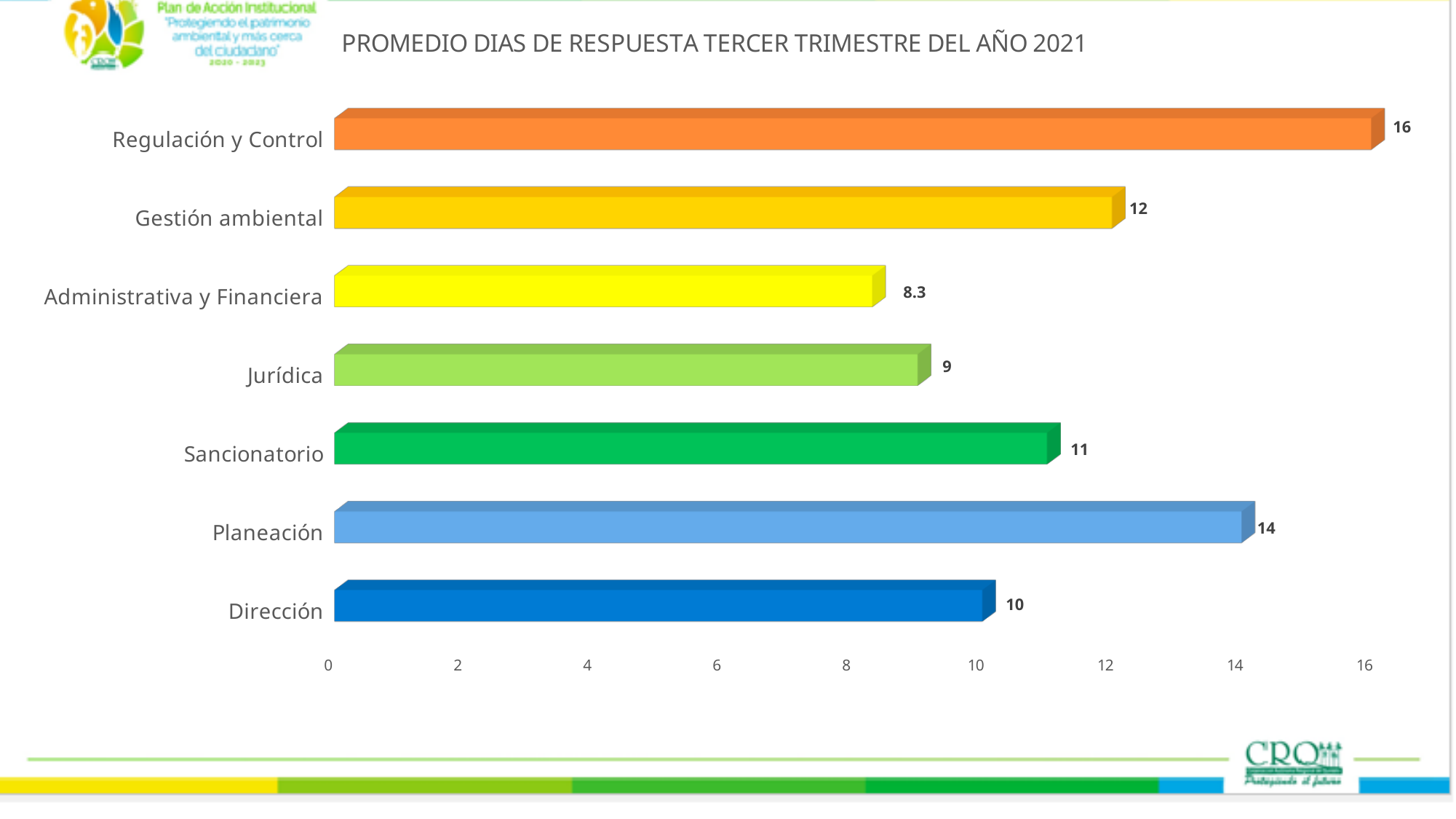
What is the difference between the values for Gestión ambiental and Jurídica? 3 What kind of chart is shown on the slide? Bar chart Which category has the lowest value? Administrativa y Financiera What is the difference between the values for Regulación y Control and Dirección? 6 What is the value for Regulación y Control? 16 Which is larger, the value for Planeación or the value for Gestión ambiental? Planeación How many categories are shown in the chart? 7 What is the value for Sancionatorio? 11 What is the value for Administrativa y Financiera? 8.3 Which category has the highest value? Regulación y Control What is the value for Planeación? 14 What is the title of the chart? PROMEDIO DIAS DE RESPUESTA TERCER TRIMESTRE DEL AÑO 2021